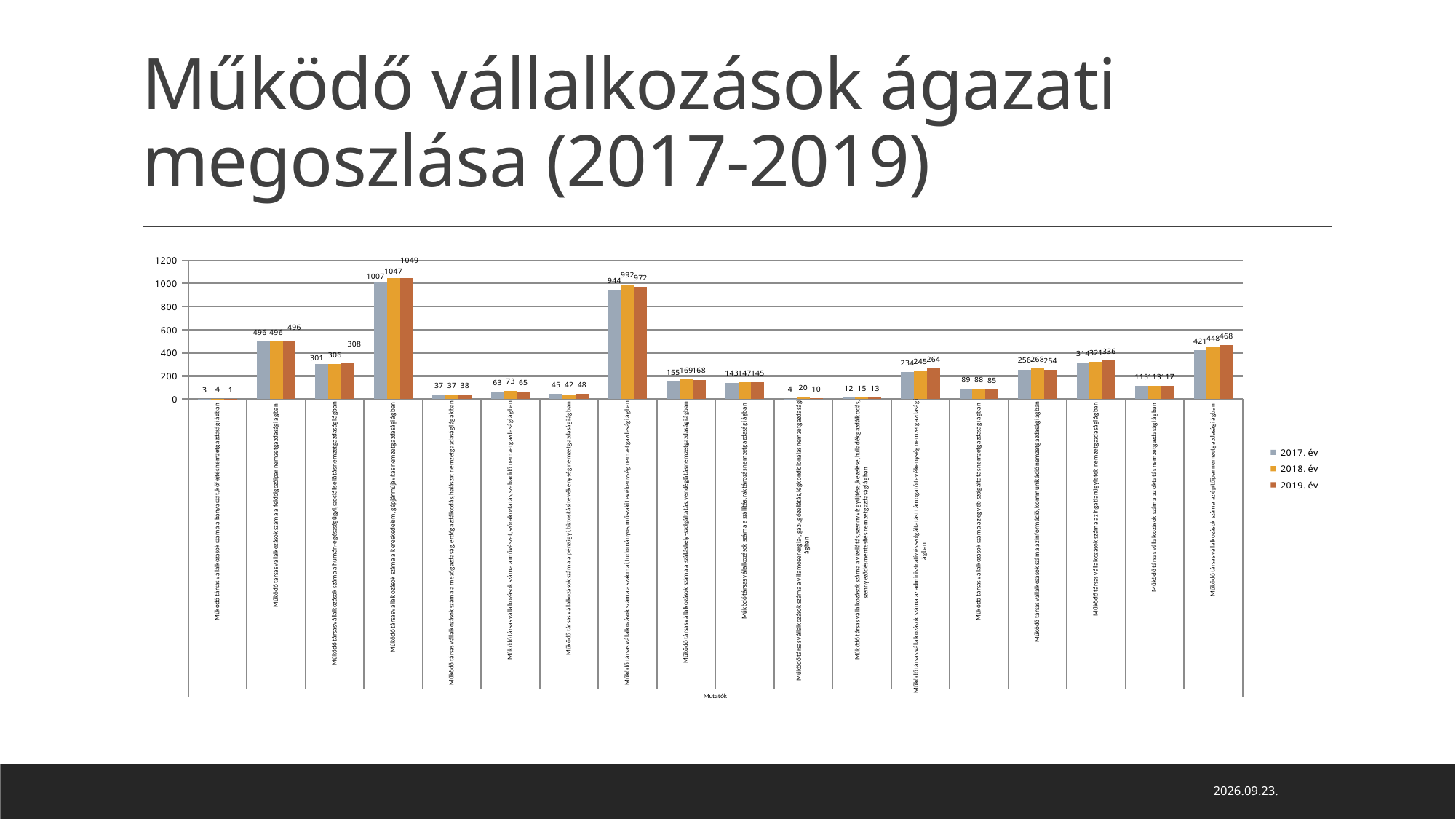
What is the label of the x axis? Mutatók How many series does the legend list? 3 Do the values for the adminisztratív és szolgáltatást támogató tevékenység category rise or fall from 2017. év to 2019. év? rise Which category has the lowest 2019. év value? bányászat, kőfejtés What is the 2018. év value for the szakmai, tudományos, műszaki tevékenység category? 992 What is the 2017. év value for the építőipar category? 421 What is the 2019. év value for the kereskedelem, gépjárműjavítás category? 1049 What kind of chart is shown on the slide? bar chart Which category has the highest value in the chart? kereskedelem, gépjárműjavítás Which is larger for the ingatlanügyletek category: the 2017. év value or the 2019. év value? 2019. év How many categories are plotted along the x axis? 18 What is the difference between the 2019. év and 2017. év values for the építőipar category? 47